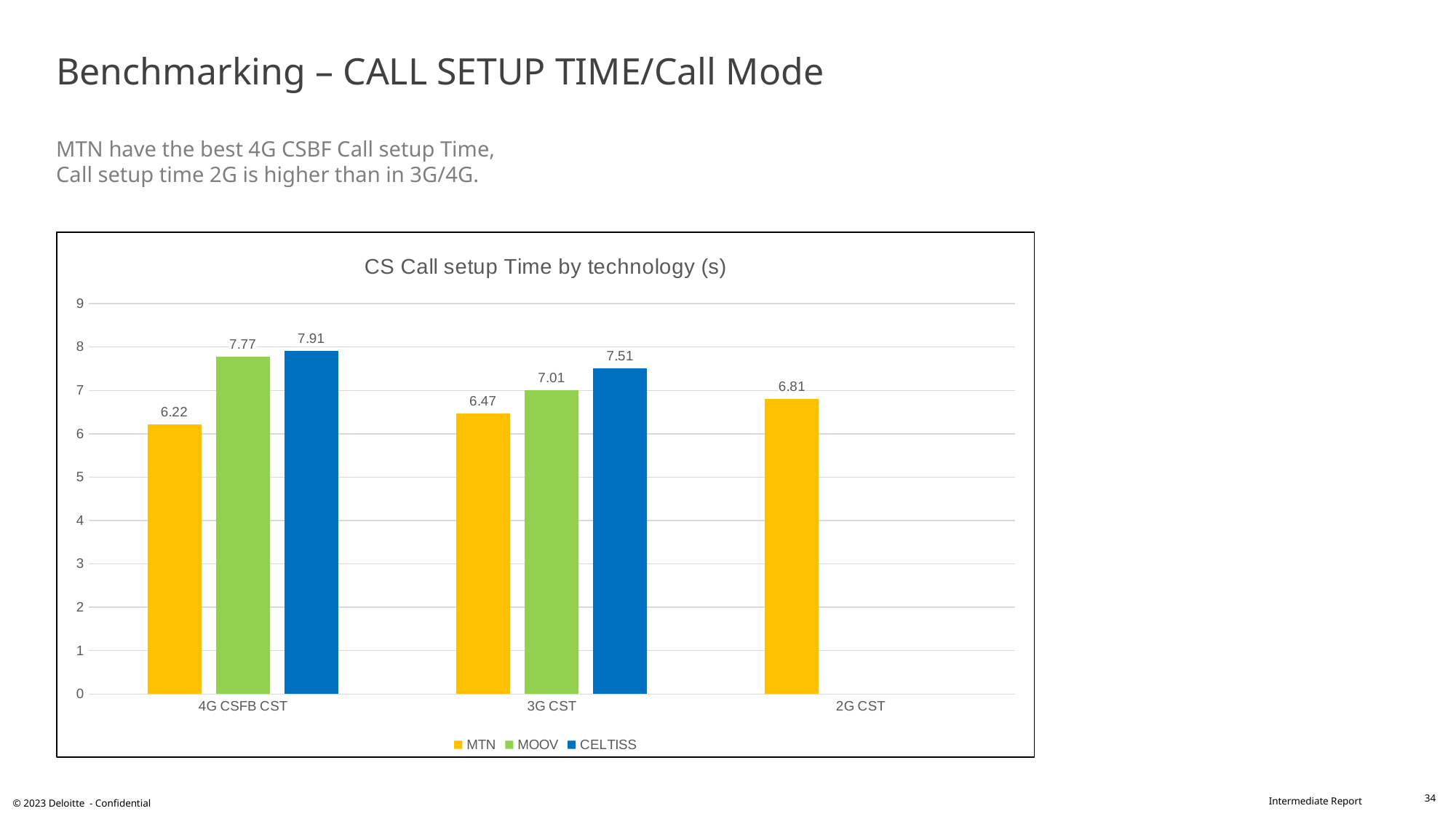
What is the MOOV value for 4G CSFB CST? 7.77 How many categories are shown on the x axis? 3 What kind of chart is shown on the slide? Bar chart What is the difference between the CELTISS and MTN values for 4G CSFB CST? 1.69 Which is larger, the MOOV value for 3G CST or the MTN value for 2G CST? MOOV value for 3G CST Which operator has the lowest call setup time for 3G CST? MTN What is the CELTISS value for 3G CST? 7.51 How many series does the legend list? 3 What is the MTN value for 4G CSFB CST? 6.22 What is the MTN value for 2G CST? 6.81 Which operator has the highest call setup time for 4G CSFB CST? CELTISS What is the title of the chart? CS Call setup Time by technology (s)